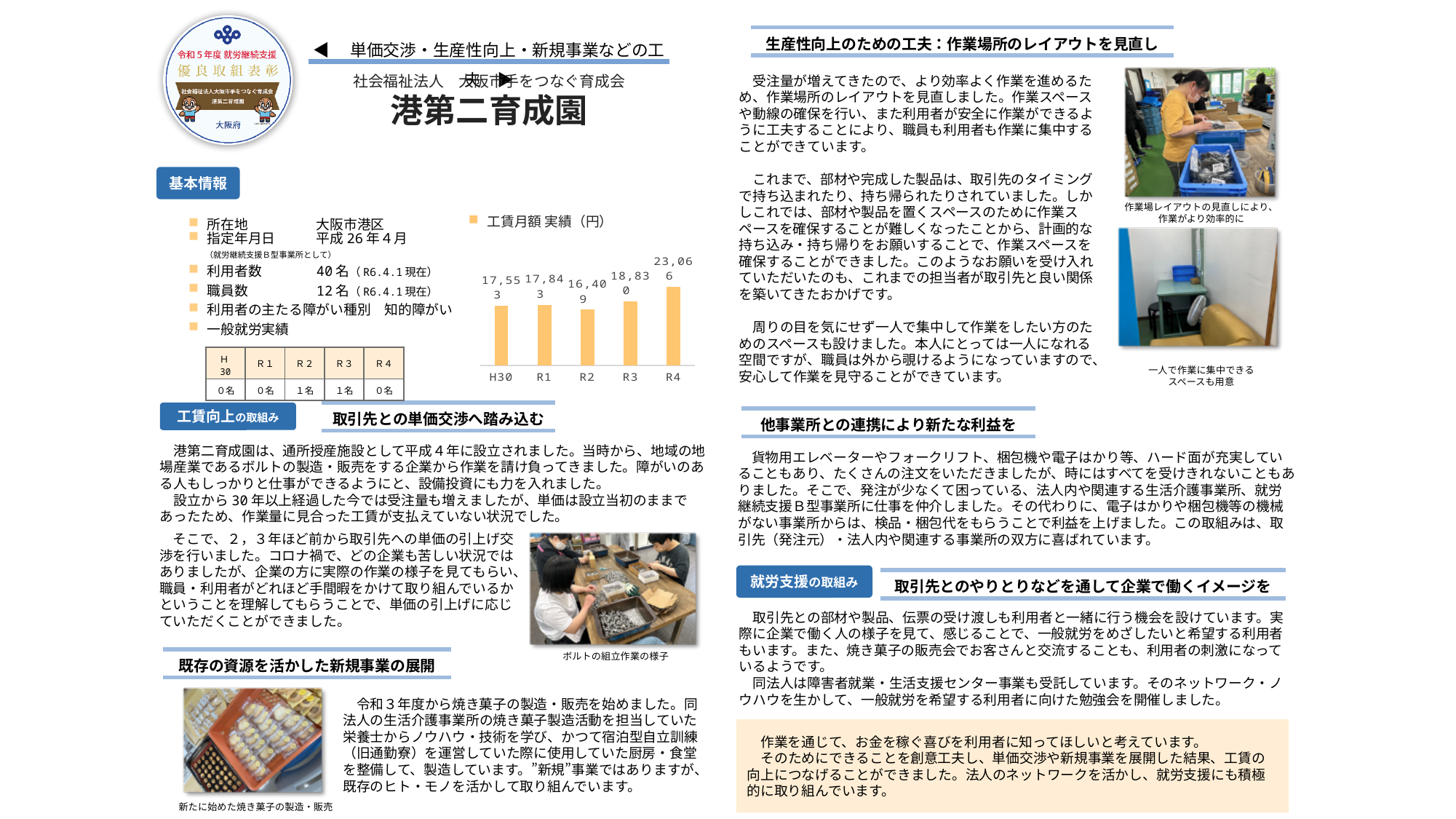
In the 工賃月額 実績（円） chart, what is the difference between the R4 and R3 values? 4,236 What is the title of the bar chart on the slide? 工賃月額 実績（円） In the 工賃月額 実績（円） chart, which year has the highest value? R4 In the 工賃月額 実績（円） chart, what is the value for R4? 23,066 In the 工賃月額 実績（円） chart, which is larger, the value for R1 or the value for R2? R1 How many years are shown on the x axis of the 工賃月額 実績（円） chart? 5 In the 工賃月額 実績（円） chart, what is the value for H30? 17,553 In the 工賃月額 実績（円） chart, what is the value for R3? 18,830 In the 工賃月額 実績（円） chart, what is the value for R2? 16,409 What type of chart is used to show 工賃月額 実績（円）? bar chart In the 工賃月額 実績（円） chart, which year has the lowest value? R2 In the 工賃月額 実績（円） chart, what is the difference between the R1 and H30 values? 290